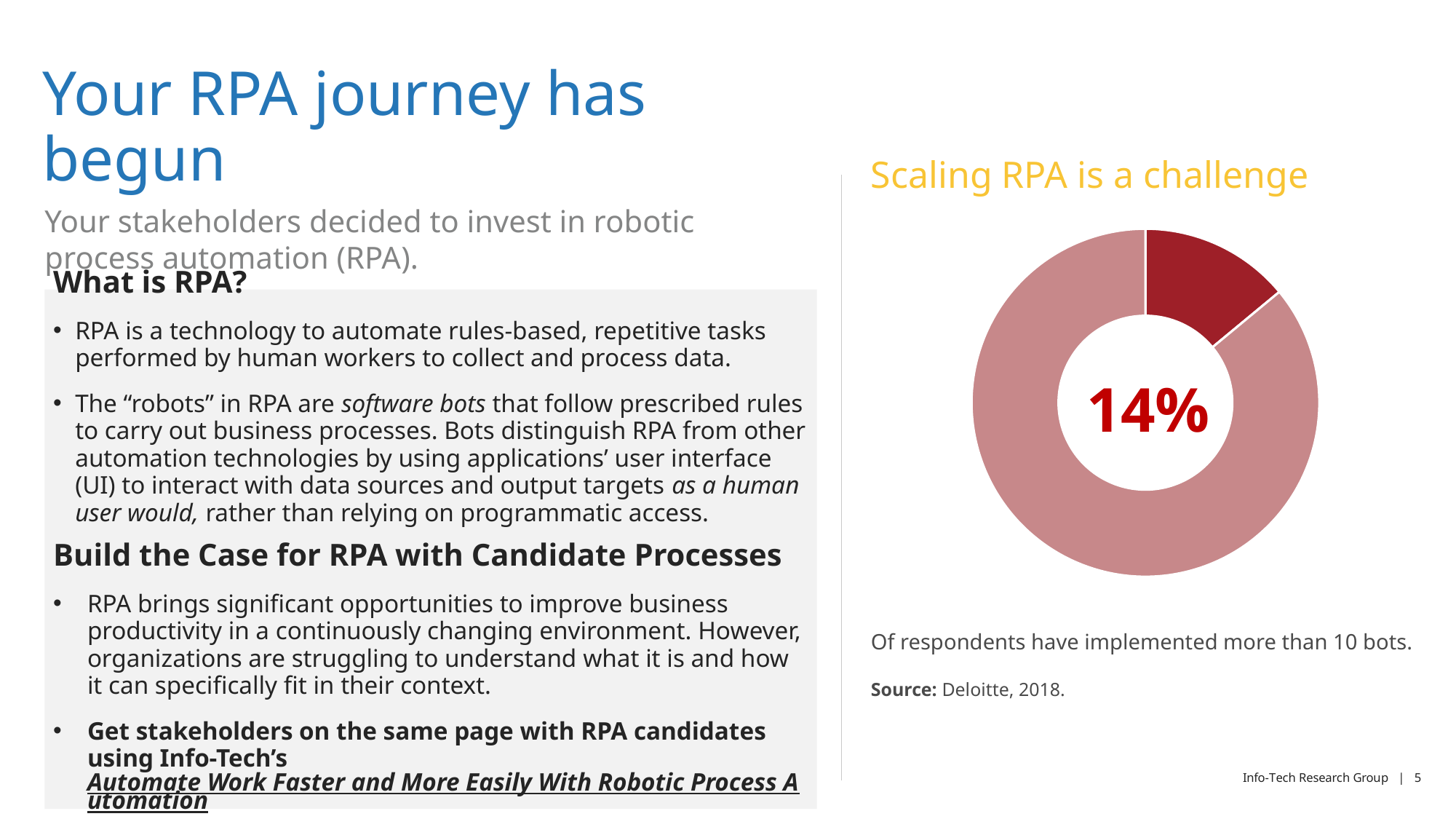
What percentage is printed in the centre of the donut chart? 14% Which slice of the donut chart is the smallest? the dark red slice (14%) Is the dark red slice of the donut chart greater or less than half of the chart? less What source is cited for the donut chart data? Deloitte, 2018 How many slices does the donut chart have? 2 Which slice of the donut chart is larger, the dark red slice or the light pink slice? the light pink slice According to the chart caption, what share of respondents have implemented more than 10 bots? 14% What kind of chart is shown on the right side of the slide? pie chart (donut) What is the title shown above the donut chart? Scaling RPA is a challenge